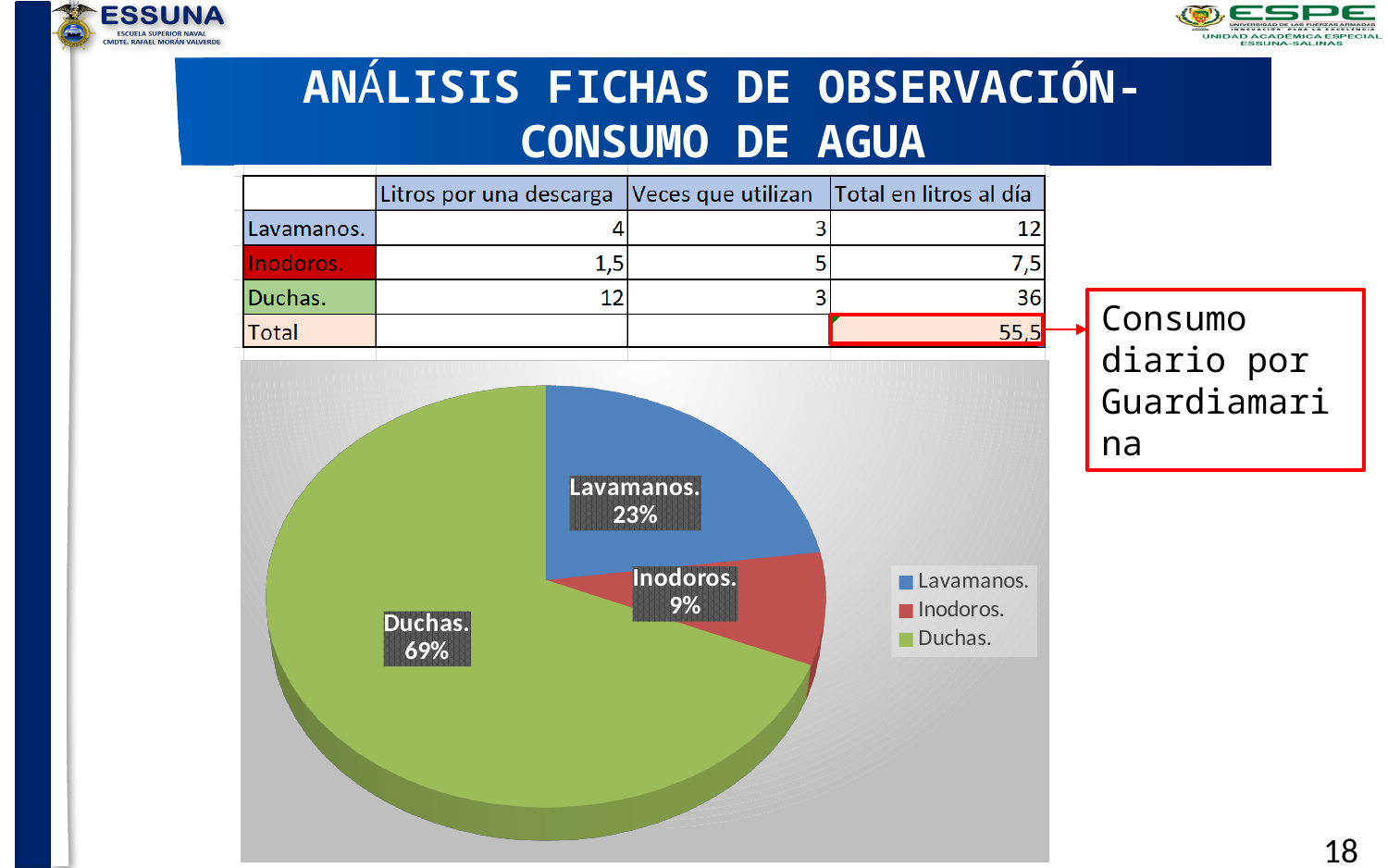
What share of the pie does Inodoros. represent? 9% What share of the pie does Duchas. represent? 69% Which legend entry is shown in red? Inodoros. How many entries does the legend list? 3 What is the difference in percentage points between the Duchas. slice and the Lavamanos. slice? 46 What kind of chart is shown on the slide? pie chart What colour is the Duchas. slice in the pie chart? green Which category has the largest slice of the pie? Duchas. What share of the pie does Lavamanos. represent? 23% How many slices does the pie chart have? 3 Which category has the smallest slice of the pie? Inodoros. Which is larger, the slice for Lavamanos. or the slice for Inodoros.? Lavamanos.